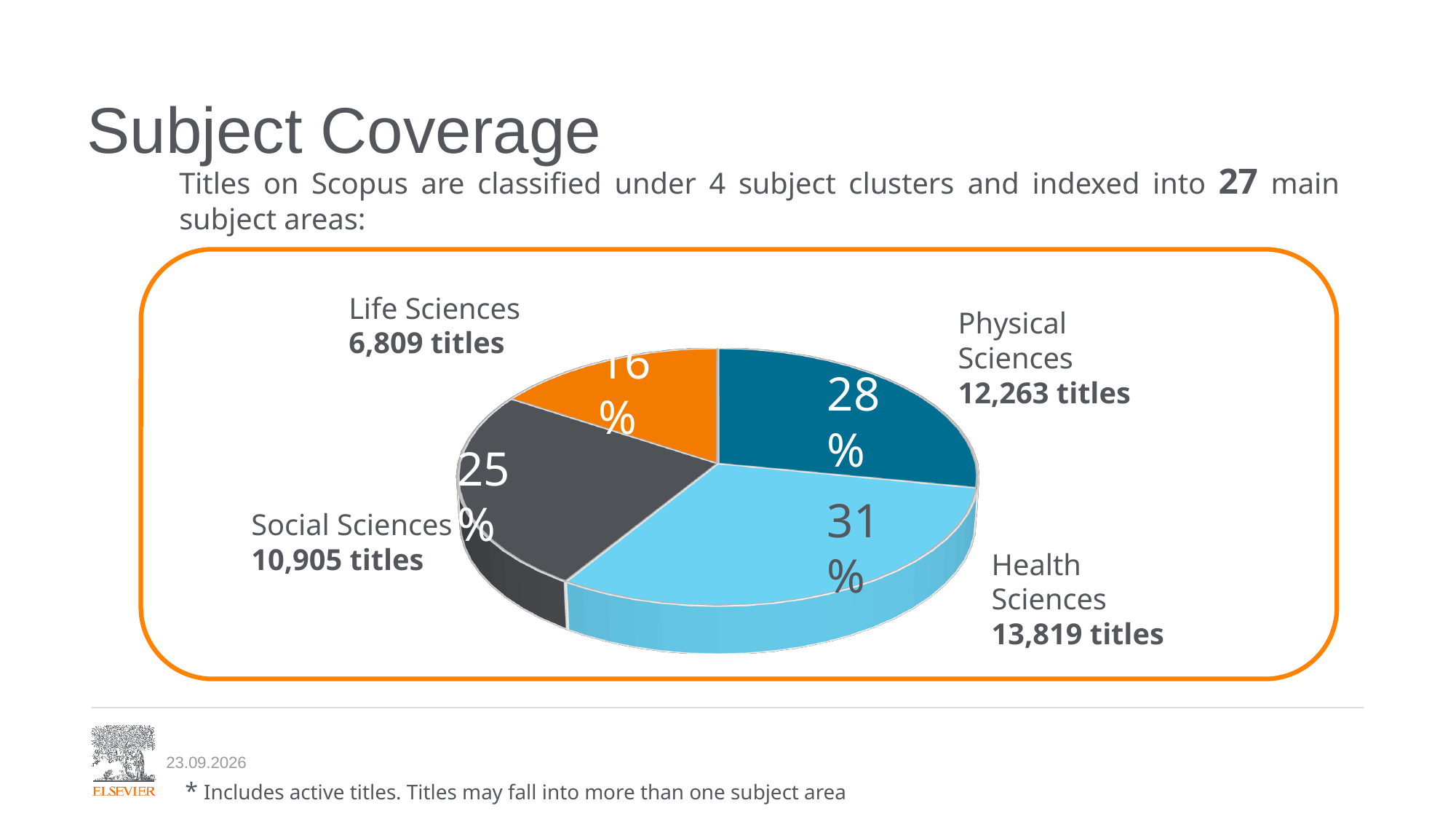
What kind of chart is shown on the slide? Pie chart How many titles are in Life Sciences? 6,809 titles Which subject cluster has the smallest share of the pie? Life Sciences What is the difference in titles between Health Sciences and Physical Sciences? 1,556 titles What share of the pie does Social Sciences represent? 25% How many titles are in Health Sciences? 13,819 titles How many titles are in Physical Sciences? 12,263 titles How many slices does the pie chart have? 4 Which has more titles, Physical Sciences or Social Sciences? Physical Sciences Which subject cluster has the largest share of the pie? Health Sciences What share of the pie does Health Sciences represent? 31% Which colour is the Life Sciences slice? Orange